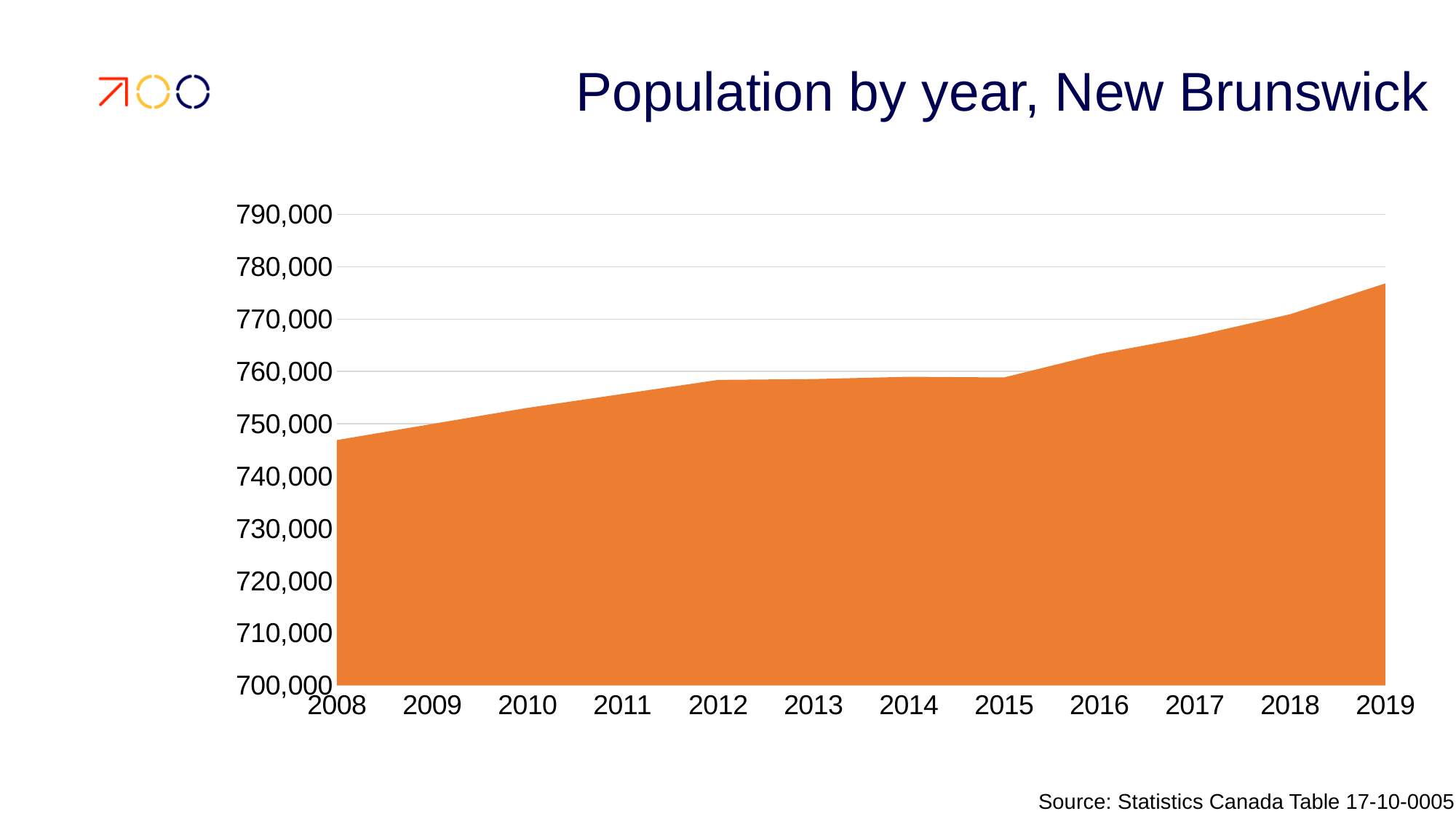
Which year has the larger population, 2010 or 2017? 2017 Do the population values generally rise or fall from 2008 to 2019? Rise Is the population for 2008 greater or less than 750,000? less Is the population for 2016 greater or less than 760,000? greater How many years are shown along the x axis? 12 Is the population for 2011 greater or less than 760,000? less Which year has the highest population? 2019 What is the title of the chart? Population by year, New Brunswick What kind of chart is shown on the slide? Area chart What source is cited for the chart data? Statistics Canada Table 17-10-0005 Which year has the lowest population? 2008